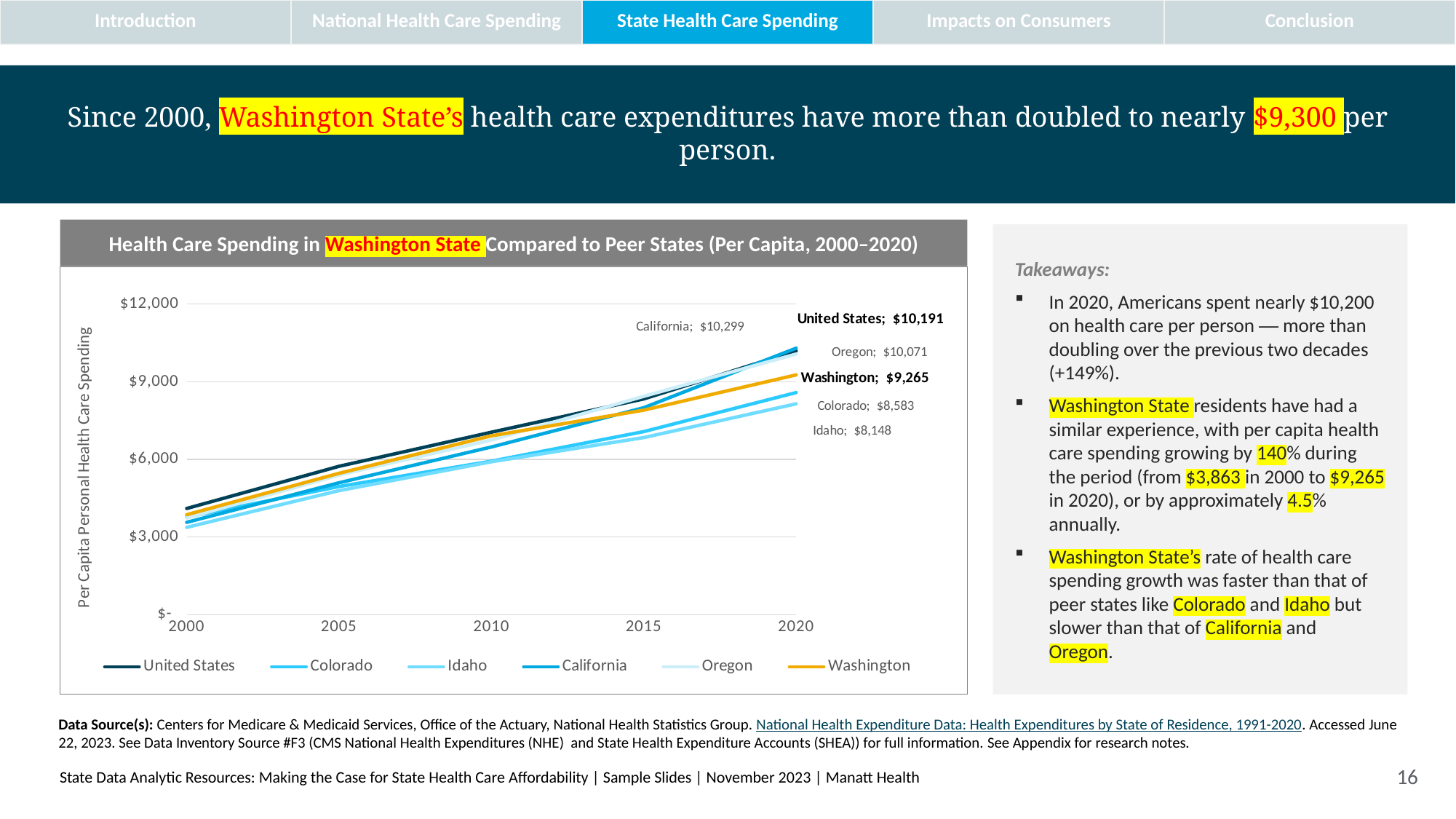
What is the 2020 value labeled for Idaho? $8,148 What is the title of the chart? Health Care Spending in Washington State Compared to Peer States (Per Capita, 2000–2020) What type of chart is shown on the slide? line chart What is the 2020 value labeled for California? $10,299 Do the values for Washington rise or fall from 2000 to 2020? rise What is the difference between the 2020 values for the United States and Washington? $926 What is the 2020 per capita health care spending value labeled for Washington? $9,265 How many series does the chart legend list? 6 Is the value for Washington in 2000 greater or less than $6,000? less In 2020, which is larger: the value for Oregon or the value for Colorado? Oregon Which series has the lowest labeled value in 2020? Idaho Which series has the highest labeled value in 2020? California